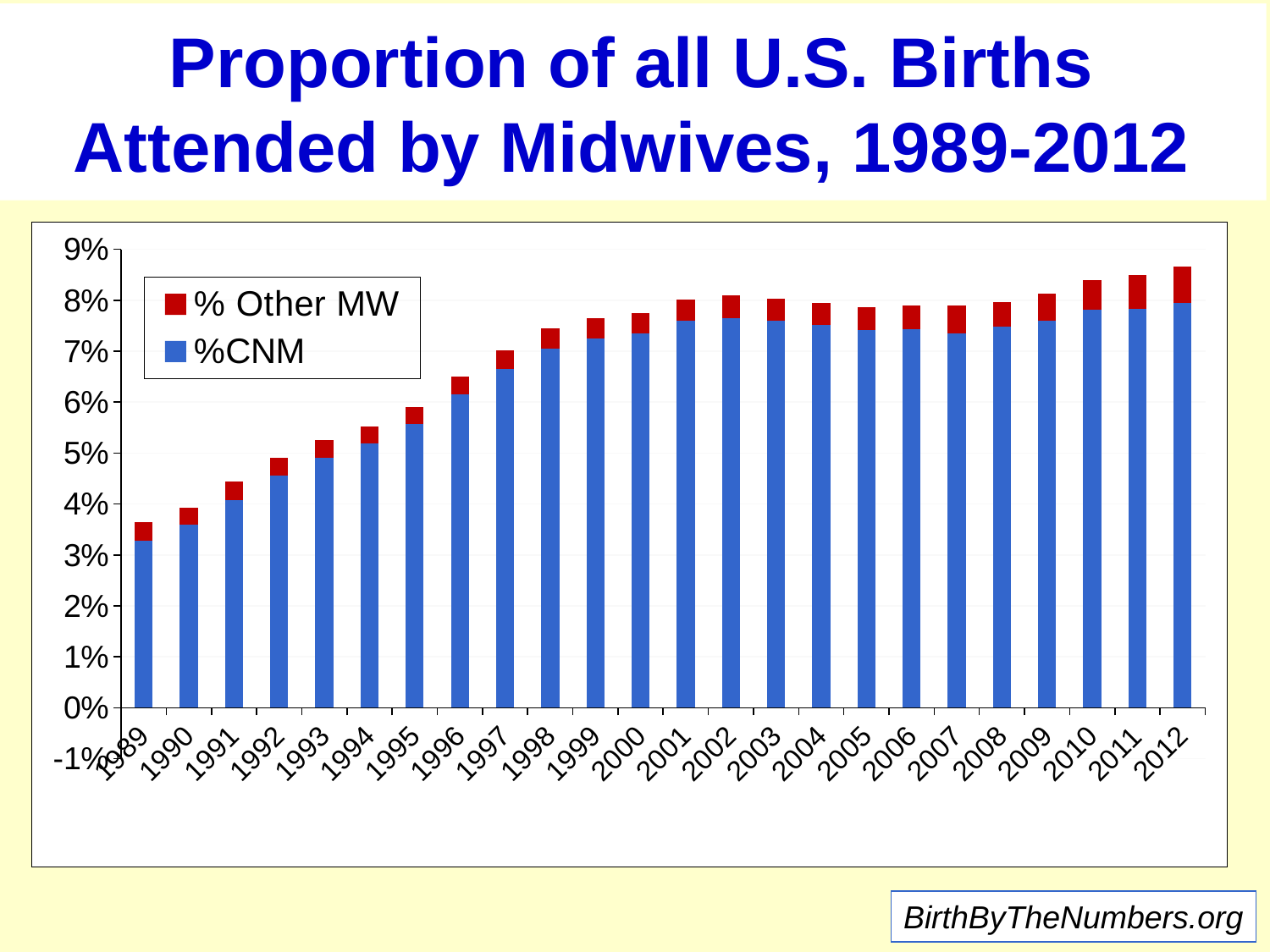
Is the %CNM value for 1997 greater or less than 6%? greater Which year has a taller stacked bar, 1995 or 2005? 2005 How many series does the legend list? 2 How many years are plotted along the x axis? 24 Which colour represents the % Other MW series? Red What kind of chart is shown on the slide? Stacked bar chart Is the total bar height for 1994 greater or less than 5%? greater Which year has the tallest stacked bar? 2012 Is the total bar height for 1989 greater or less than 4%? less Which year has the shortest stacked bar? 1989 Do the total bar heights generally rise or fall from 1989 to 2012? Rise